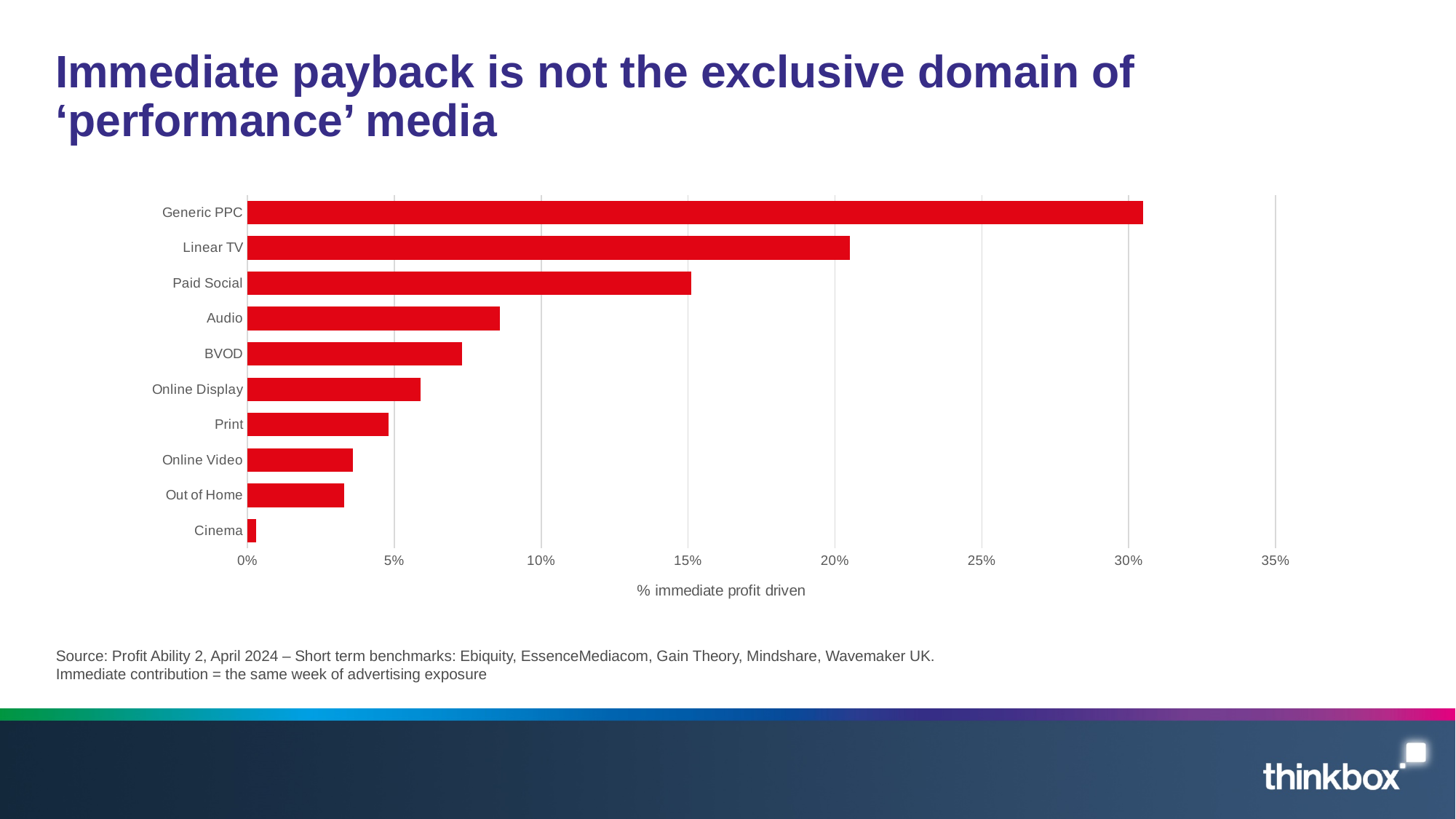
How many categories are plotted in the chart? 10 Which category has the lowest % immediate profit driven? Cinema What type of chart is shown on the slide? bar chart Is the value for Generic PPC greater or less than 30%? greater Is the value for Online Display greater or less than 5%? greater Which has a higher % immediate profit driven, BVOD or Audio? Audio Is the value for Audio greater or less than 10%? less What is the label on the horizontal axis of the chart? % immediate profit driven Which category has the highest % immediate profit driven? Generic PPC Which has a higher % immediate profit driven, Linear TV or Paid Social? Linear TV